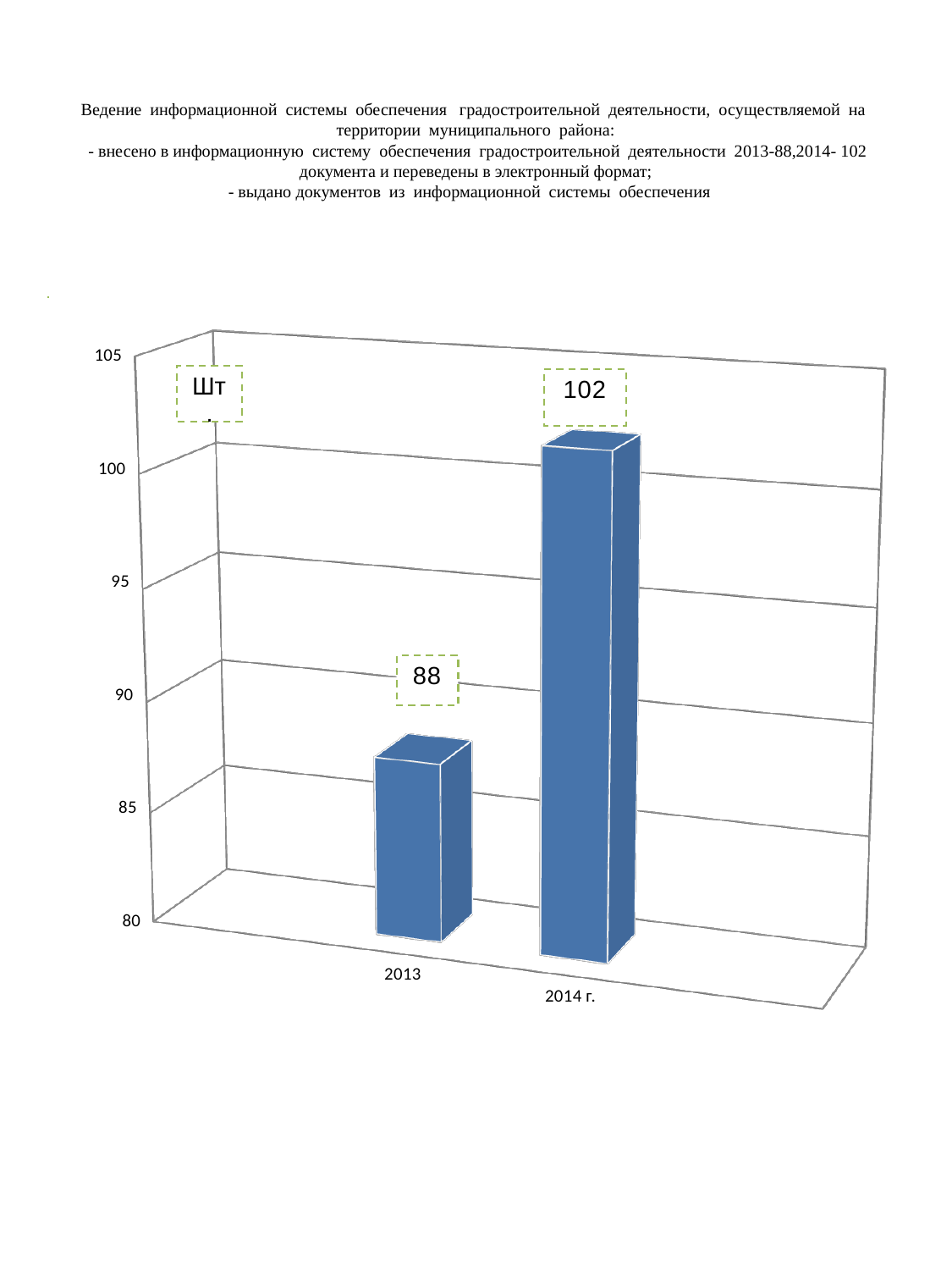
What is the difference between the values for 2014 г. and 2013? 14 Is the value for 2014 г. greater or less than 100? greater What is the value for 2014 г.? 102 Which is larger, the value for 2013 or the value for 2014 г.? 2014 г. Which category has the lowest value? 2013 Which category has the highest value? 2014 г. What kind of chart is shown on the slide? bar chart What unit label is shown in the box at the top left of the chart? Шт How many categories are shown on the x axis? 2 What is the value for 2013? 88 Do the values rise or fall from 2013 to 2014 г.? rise Is the value for 2013 greater or less than 90? less